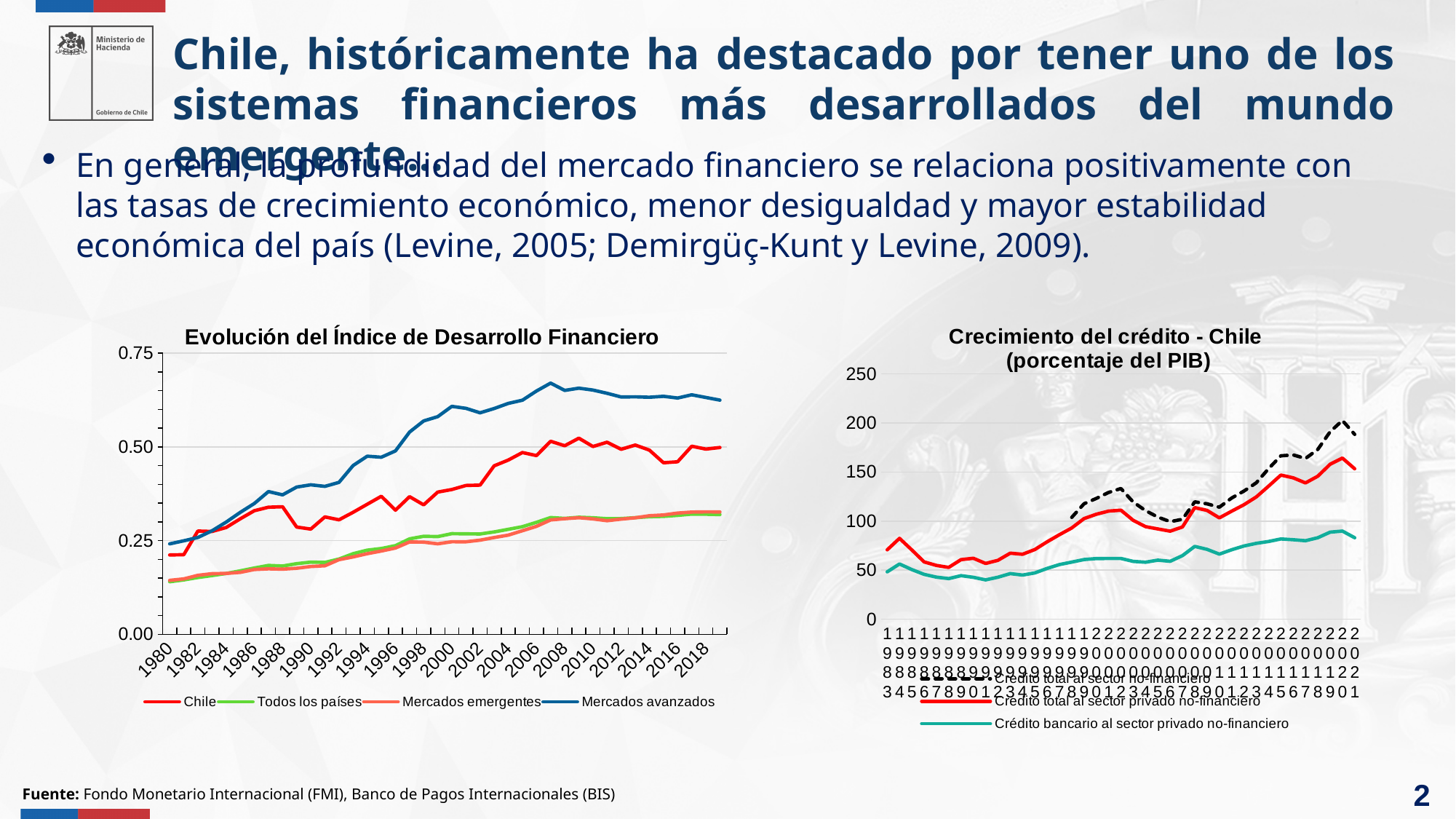
How many series does the legend of the 'Evolución del Índice de Desarrollo Financiero' chart list? 4 In the 'Crecimiento del crédito - Chile' chart, is the value for Crédito bancario al sector privado no-financiero in 2021 greater or less than 100? less In the 'Evolución del Índice de Desarrollo Financiero' chart, which series has the highest value in 2018? Mercados avanzados In the 'Evolución del Índice de Desarrollo Financiero' chart, is the value for Mercados avanzados in 2018 greater or less than 0.50? greater What kind of chart is the 'Crecimiento del crédito - Chile' chart? line chart In the 'Evolución del Índice de Desarrollo Financiero' chart, which is larger in 2018: Chile or Mercados avanzados? Mercados avanzados What is the subtitle in parentheses of the right-hand chart? porcentaje del PIB How many series does the legend of the 'Crecimiento del crédito - Chile' chart list? 3 What kind of chart is the 'Evolución del Índice de Desarrollo Financiero' chart? line chart In the 'Evolución del Índice de Desarrollo Financiero' chart, is the value for Chile in 1980 greater or less than 0.25? less In the 'Evolución del Índice de Desarrollo Financiero' chart, does the Mercados avanzados series rise or fall overall from 1980 to 2018? rise In the 'Crecimiento del crédito - Chile' chart, which series has the lowest values across the whole period? Crédito bancario al sector privado no-financiero